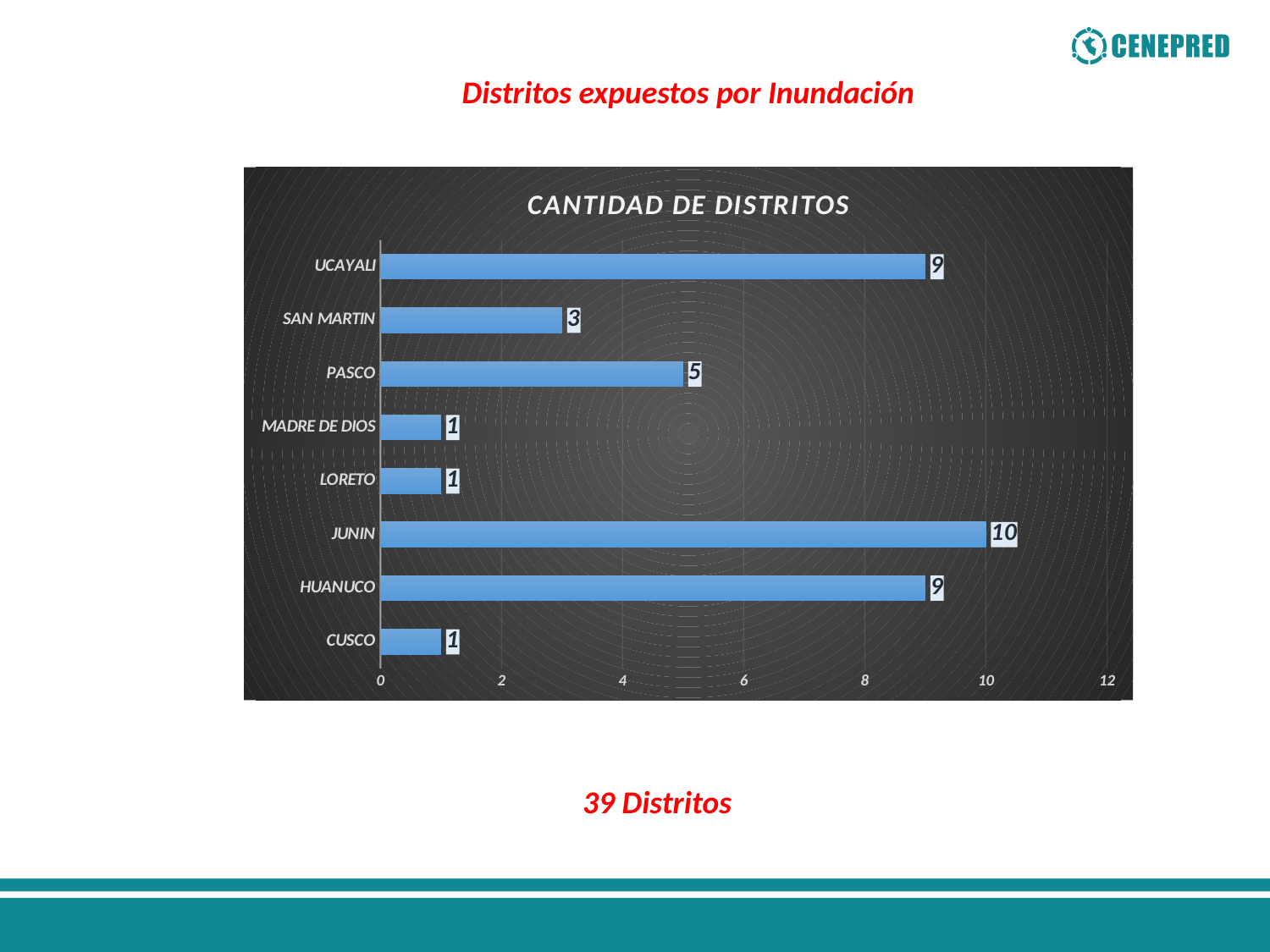
What is the difference between the values for HUANUCO and PASCO? 4 What is the difference between the values for JUNIN and SAN MARTIN? 7 Which category has the highest value? JUNIN What is the value for SAN MARTIN? 3 What is the value for PASCO? 5 What is the value for UCAYALI? 9 How many categories are shown in the chart? 8 What kind of chart is shown on the slide? bar chart What is the title of the chart? CANTIDAD DE DISTRITOS Is the value for UCAYALI greater or less than 8? greater What is the value for JUNIN? 10 Which is larger, the value for PASCO or the value for SAN MARTIN? PASCO